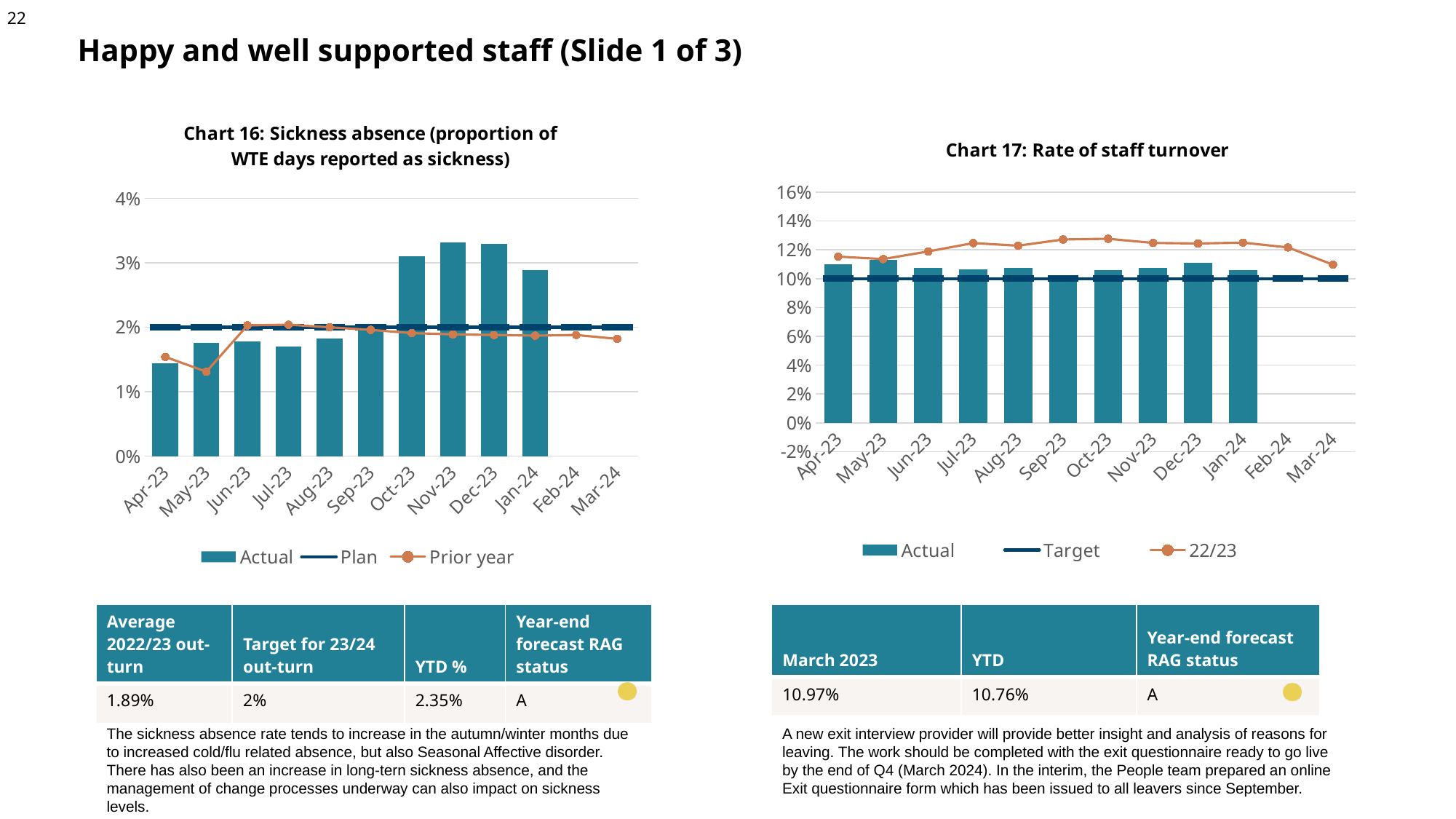
In Chart 16, which month has the lowest Actual bar? Apr-23 In Chart 16, is the Actual value for Jan-24 greater or less than 2%? greater In Chart 16, is the Actual value for Apr-23 greater or less than 2%? less In Chart 16, is the Actual value for Nov-23 greater or less than 3%? greater In Chart 17, how many months have an Actual bar plotted? 10 What kind of chart is used for the Actual series in Chart 17? Bar chart In Chart 17, what are the three legend entries? Actual, Target, 22/23 In Chart 16, how many months are labelled on the x axis? 12 In Chart 16, which is larger, the Actual bar for Oct-23 or the Actual bar for Sep-23? Oct-23 In Chart 16, how many series does the legend list? 3